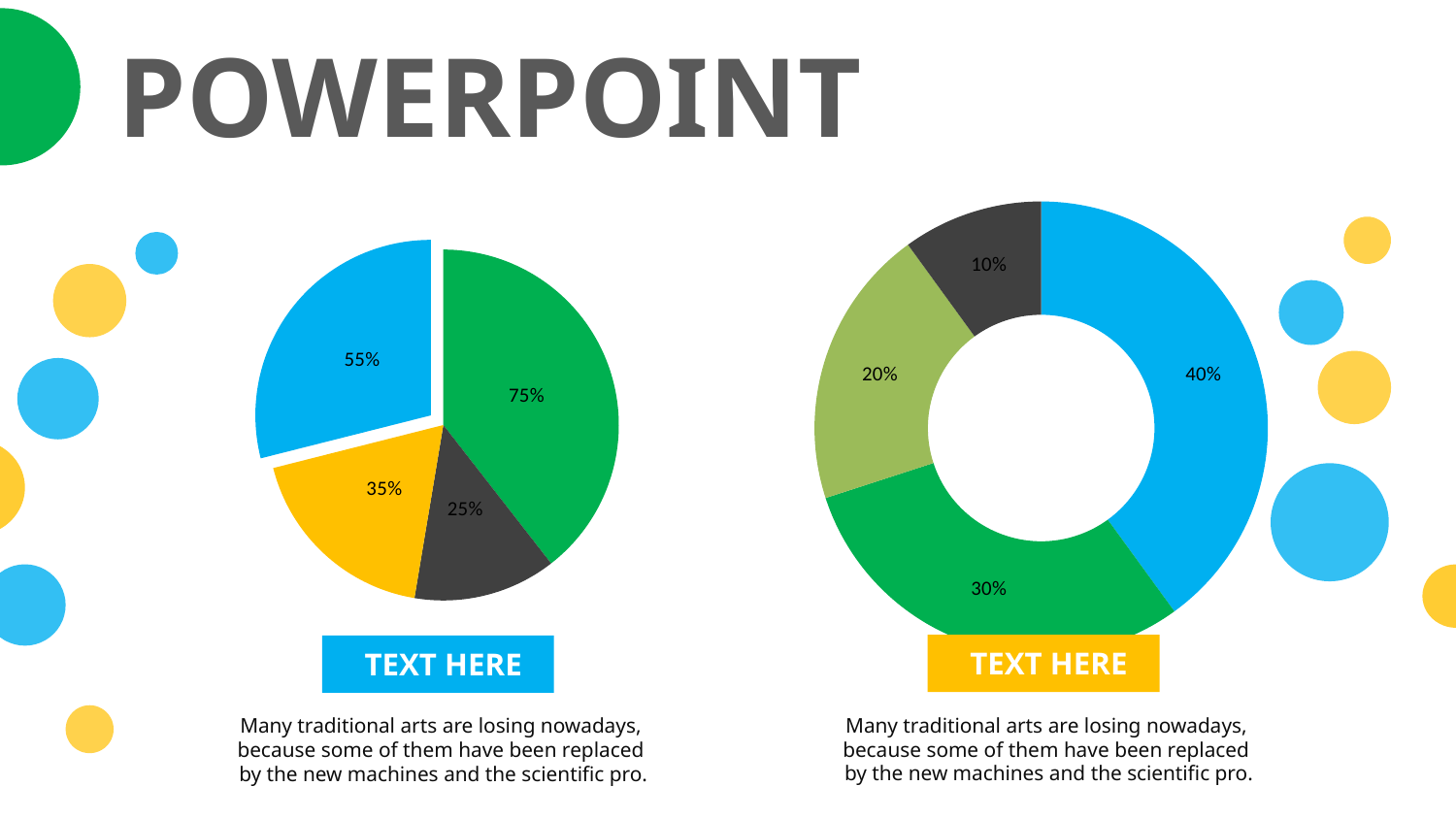
In the pie chart on the left, what is the difference between the green slice (75%) and the yellow slice (35%)? 40% In the pie chart on the left, what value is shown on the blue slice? 55% In the doughnut chart on the right, what is the value of the smallest segment? 10% In the pie chart on the left, what is the value of the largest slice? 75% In the doughnut chart on the right, how many segments are there? 4 In the pie chart on the left, how many slices are there? 4 In the pie chart on the left, what is the value of the smallest slice? 25% In the doughnut chart on the right, which is larger, the blue segment or the green segment? the blue segment (40%) In the doughnut chart on the right, what is the value of the largest segment? 40% What kind of chart is the chart on the left of the slide? pie chart What kind of chart is the chart on the right of the slide? doughnut chart In the doughnut chart on the right, what value is shown on the dark grey segment? 10%